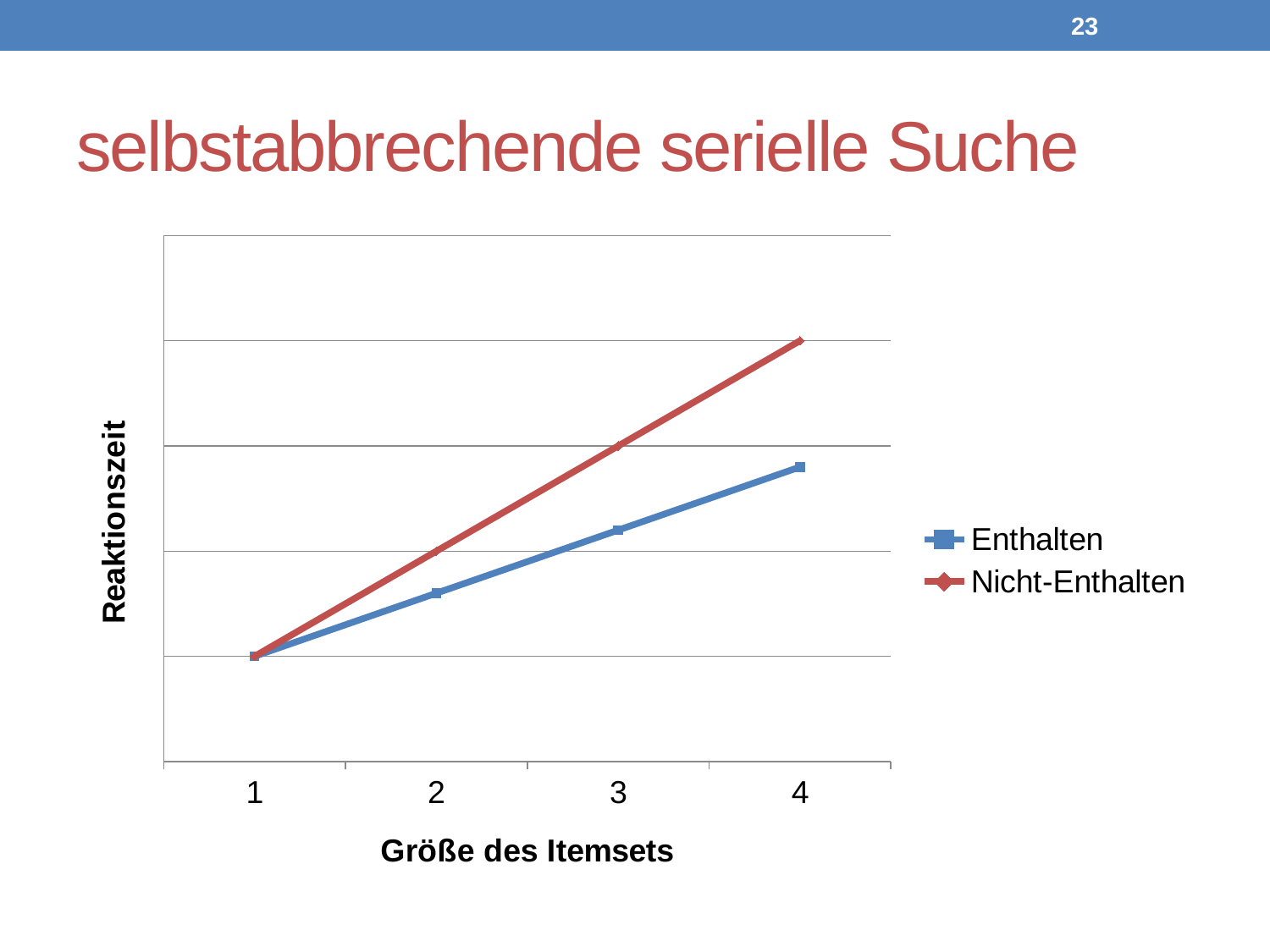
Which series reaches the highest Reaktionszeit on the chart? Nicht-Enthalten Does the Reaktionszeit for Nicht-Enthalten rise or fall as Größe des Itemsets increases from 1 to 4? rise What kind of chart is shown on the slide? line chart At Größe des Itemsets 3, which series has the lower Reaktionszeit, Enthalten or Nicht-Enthalten? Enthalten How many points are plotted along the x axis for each series? 4 Does the Reaktionszeit for Enthalten rise or fall as Größe des Itemsets increases from 1 to 4? rise At Größe des Itemsets 4, which series has the higher Reaktionszeit, Enthalten or Nicht-Enthalten? Nicht-Enthalten For the Enthalten series, at which Größe des Itemsets is the Reaktionszeit lowest? 1 Which series is drawn in red? Nicht-Enthalten What is the label of the x axis? Größe des Itemsets How many series does the legend list? 2